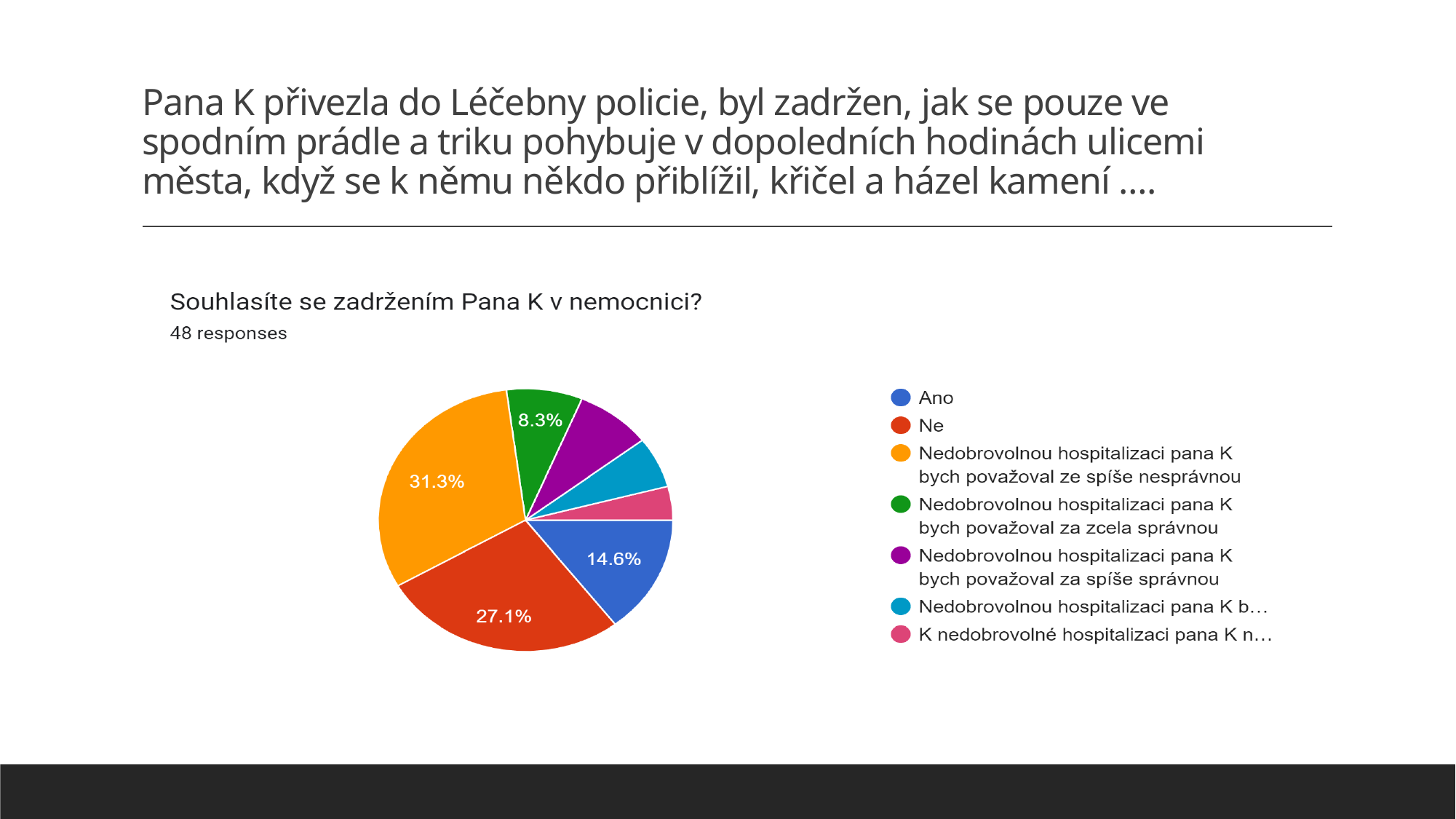
How many responses does the chart report? 48 responses What share of responses is "Ano"? 14.6% What share of responses is "Ne"? 27.1% Which is larger, the share for "Ano" or the share for "Ne"? Ne Which response has the largest share of the pie? Nedobrovolnou hospitalizaci pana K bych považoval ze spíše nesprávnou How many slices does the pie chart have? 7 How many entries does the legend list? 7 What share of responses is "Nedobrovolnou hospitalizaci pana K bych považoval ze spíše nesprávnou"? 31.3% How many percentage points larger is the "Nedobrovolnou hospitalizaci pana K bych považoval ze spíše nesprávnou" share than the "Ne" share? 4.2 What share of responses is "Nedobrovolnou hospitalizaci pana K bych považoval za zcela správnou"? 8.3% How many percentage points larger is the "Ne" share than the "Ano" share? 12.5 What type of chart is shown on the slide? pie chart